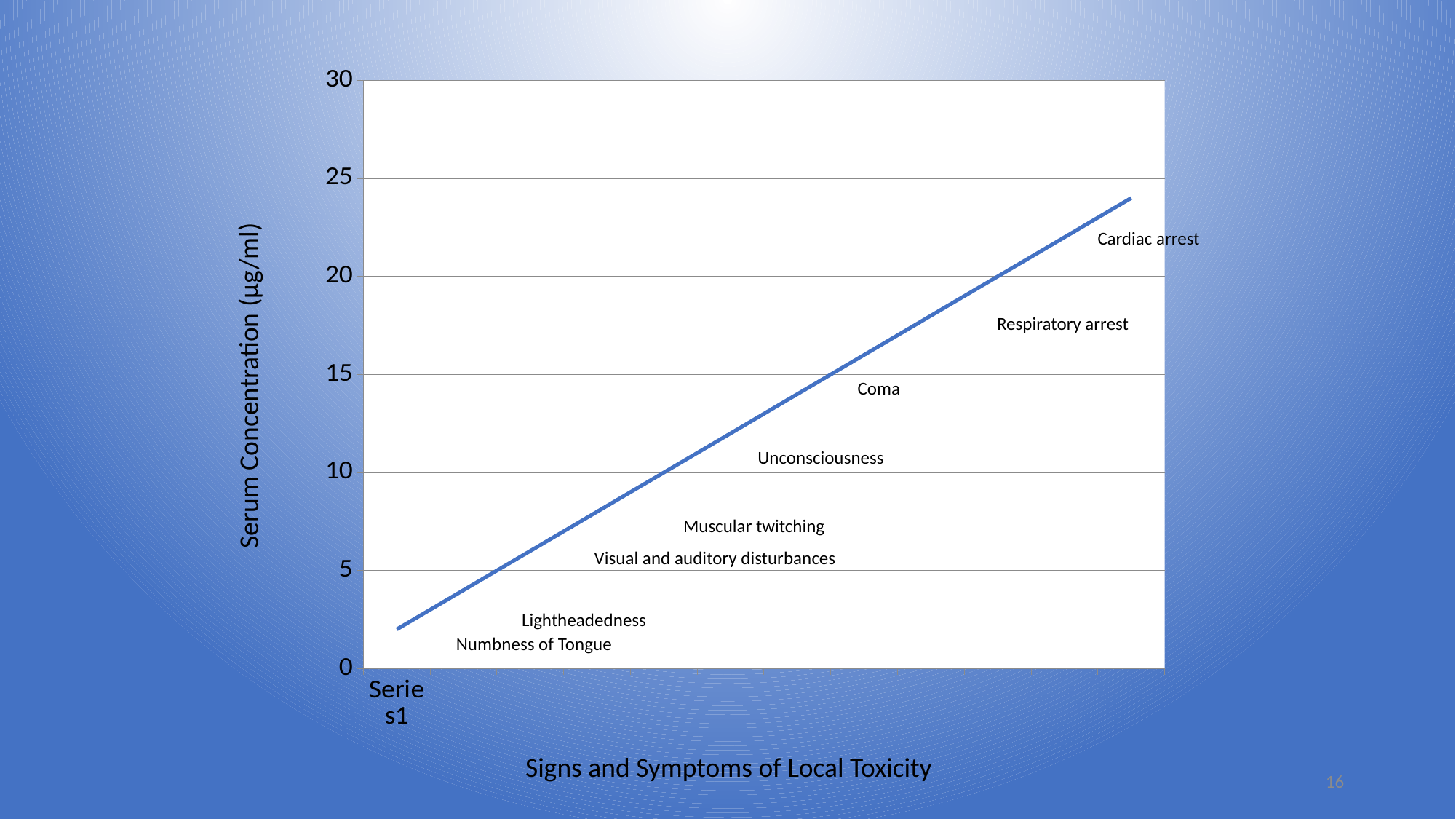
Which symptom label is placed lowest on the chart? Numbness of Tongue Is the value of the line at its right-hand end greater or less than 20? greater Does the line rise or fall from left to right across the chart? rises What is the title of the horizontal axis? Signs and Symptoms of Local Toxicity What kind of chart is shown on the slide? line chart Is the value of the line at its starting point (Series1) greater or less than 5? less What is the title of the vertical axis? Serum Concentration (μg/ml) What is the highest value shown on the vertical axis? 30 How many symptom labels are written on the chart? 8 Which symptom label is placed higher on the chart, Coma or Muscular twitching? Coma Which symptom label is placed highest on the chart? Cardiac arrest Is the value of the line at its right-hand end greater or less than 25? less